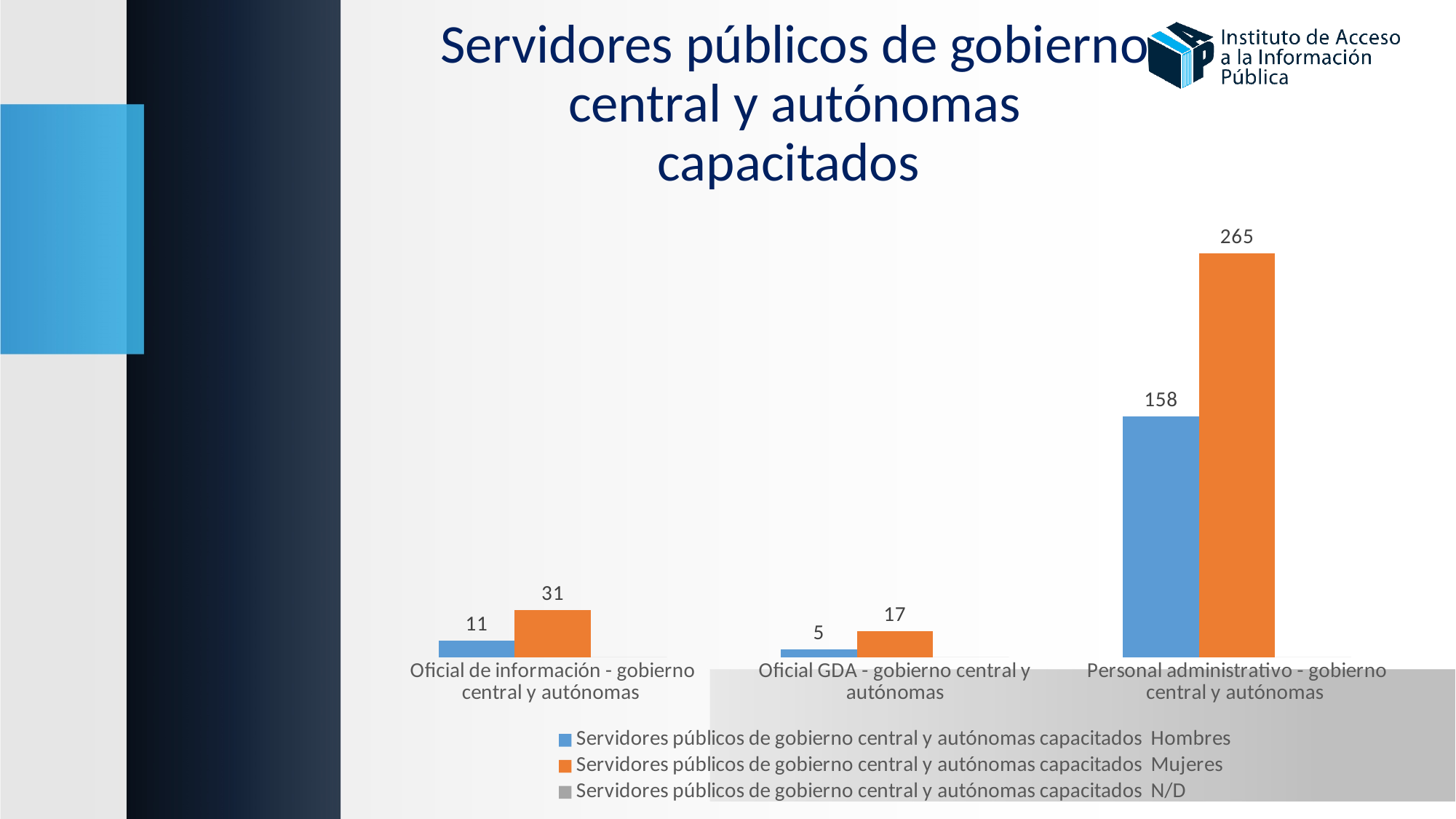
What is the value for Hombres in the 'Personal administrativo - gobierno central y autónomas' category? 158 What is the difference between the Mujeres and Hombres values in the 'Personal administrativo - gobierno central y autónomas' category? 107 Which category has the lowest Hombres value? Oficial GDA - gobierno central y autónomas What is the value for Mujeres in the 'Oficial GDA - gobierno central y autónomas' category? 17 What is the value for Mujeres in the 'Oficial de información - gobierno central y autónomas' category? 31 What kind of chart is shown on the slide? Bar chart Which category has the highest Mujeres value? Personal administrativo - gobierno central y autónomas What colour represents the Mujeres series? Orange Which is larger in the 'Oficial de información - gobierno central y autónomas' category: Hombres or Mujeres? Mujeres What is the value for Hombres in the 'Oficial GDA - gobierno central y autónomas' category? 5 How many series does the legend list? 3 How many categories are shown on the x axis? 3